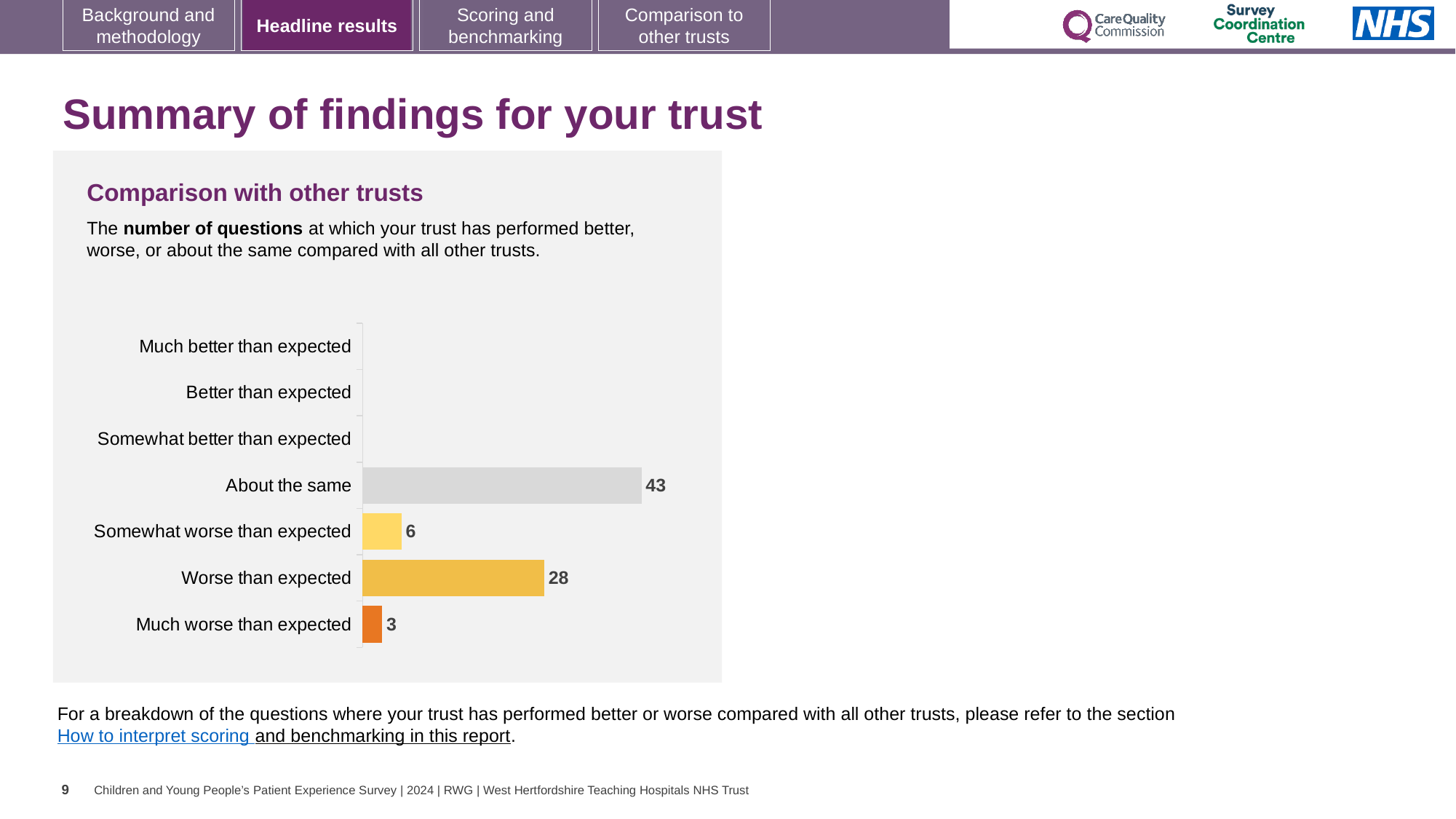
What is the value for "Much worse than expected"? 3 How many categories are listed on the chart's axis? 7 What is the title of the chart section? Comparison with other trusts What is the total of the values shown for the three "worse than expected" categories? 37 Which category has the highest value? About the same What is the value for "Worse than expected"? 28 What is the value for "About the same"? 43 What is the difference between the values for "About the same" and "Worse than expected"? 15 What kind of chart is shown on the slide? Bar chart What is the difference between the values for "Somewhat worse than expected" and "Much worse than expected"? 3 Which is larger, the value for "Worse than expected" or the value for "Somewhat worse than expected"? Worse than expected What is the value for "Somewhat worse than expected"? 6